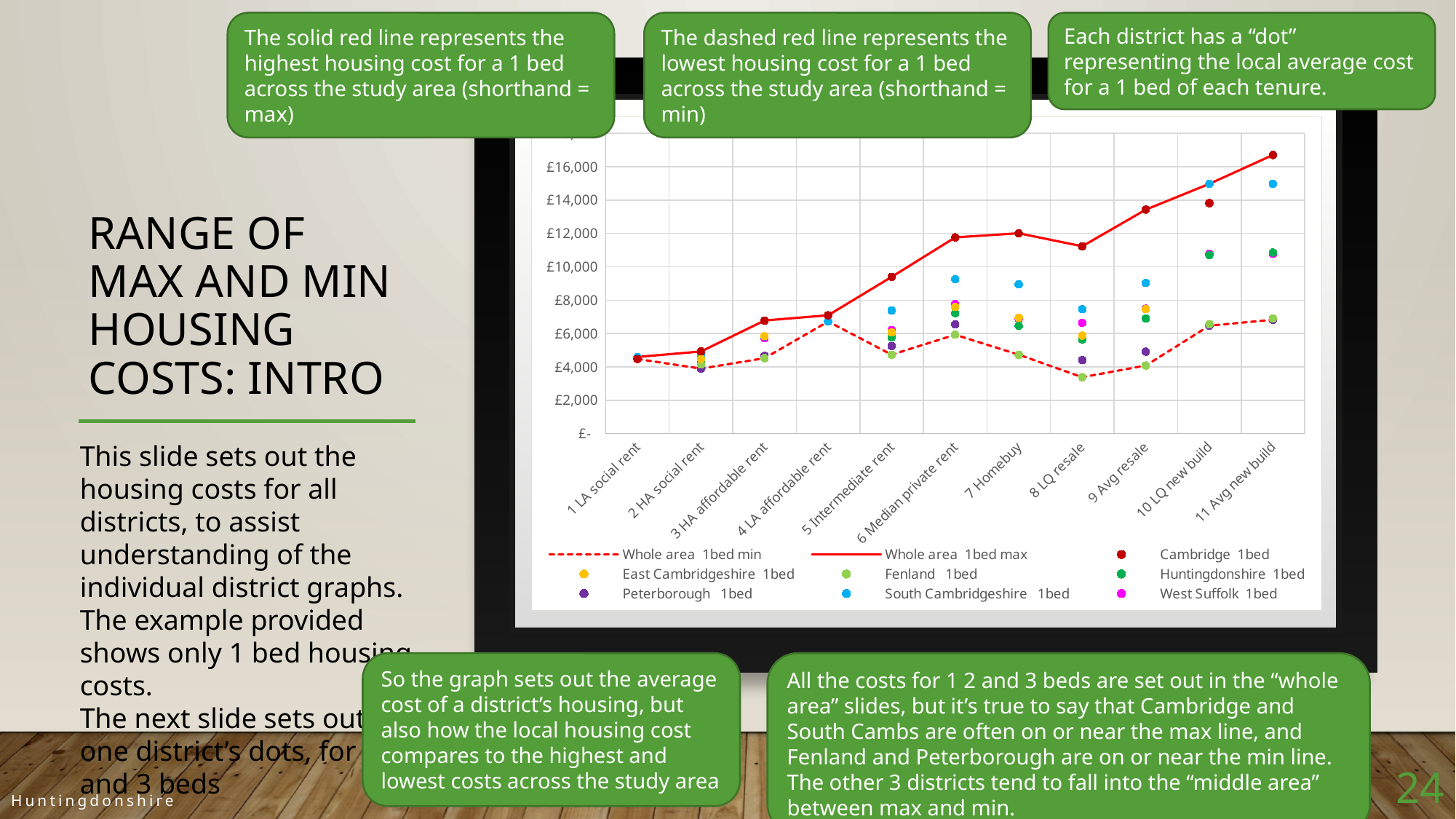
Is the Whole area 1bed max value for 11 Avg new build greater or less than £16,000? greater How many categories are shown along the x axis of the chart? 11 Does the Whole area 1bed max line generally rise or fall from 1 LA social rent to 11 Avg new build? Rise At 11 Avg new build, which is larger: the Cambridge 1bed value or the Fenland 1bed value? Cambridge 1bed How many series does the chart's legend list? 9 Which category has the highest value on the Whole area 1bed max line? 11 Avg new build Is the South Cambridgeshire 1bed value for 10 LQ new build greater or less than £14,000? greater Is the Whole area 1bed min value for 8 LQ resale greater or less than £4,000? less Which category has the lowest value on the Whole area 1bed min line? 8 LQ resale What kind of chart is shown on the slide? Line chart Which legend entry is drawn as a dashed red line? Whole area 1bed min